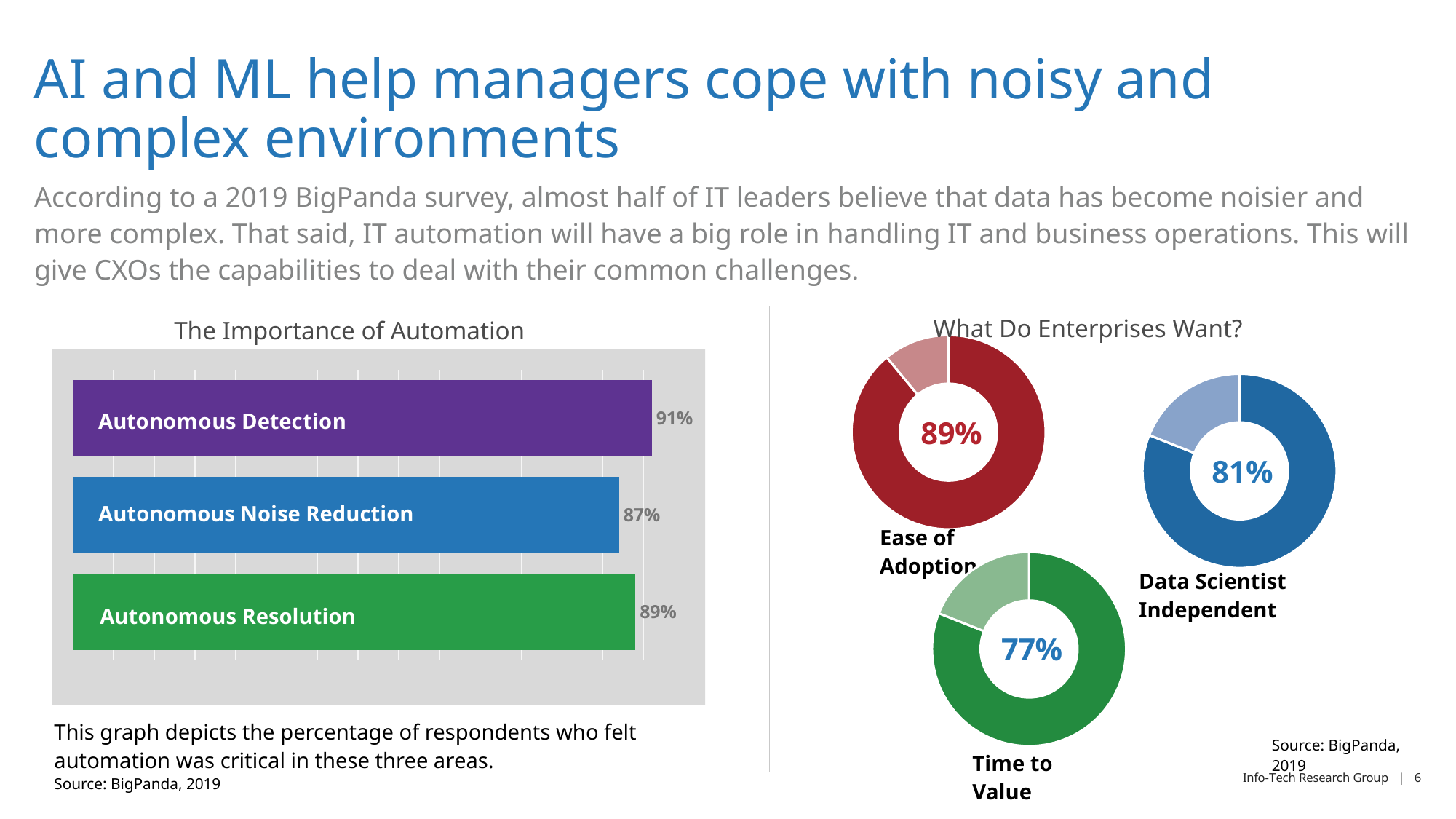
In the chart 'The Importance of Automation', which category has the highest value? Autonomous Detection In the chart 'The Importance of Automation', what is the value for Autonomous Detection? 91% In the chart 'The Importance of Automation', what is the difference between Autonomous Detection and Autonomous Noise Reduction? 4% In the chart 'The Importance of Automation', what is the value for Autonomous Noise Reduction? 87% What kind of chart is 'The Importance of Automation'? Bar chart In the chart 'The Importance of Automation', how many categories are shown? 3 In the 'What Do Enterprises Want?' charts, what is the difference between Ease of Adoption and Data Scientist Independent? 8% In the 'What Do Enterprises Want?' charts, which is larger: Data Scientist Independent or Time to Value? Data Scientist Independent In the chart 'The Importance of Automation', which category has the lowest value? Autonomous Noise Reduction In the chart 'The Importance of Automation', what is the value for Autonomous Resolution? 89% In the 'What Do Enterprises Want?' charts, what percentage is shown for Time to Value? 77% In the 'What Do Enterprises Want?' charts, what percentage is shown for Ease of Adoption? 89%